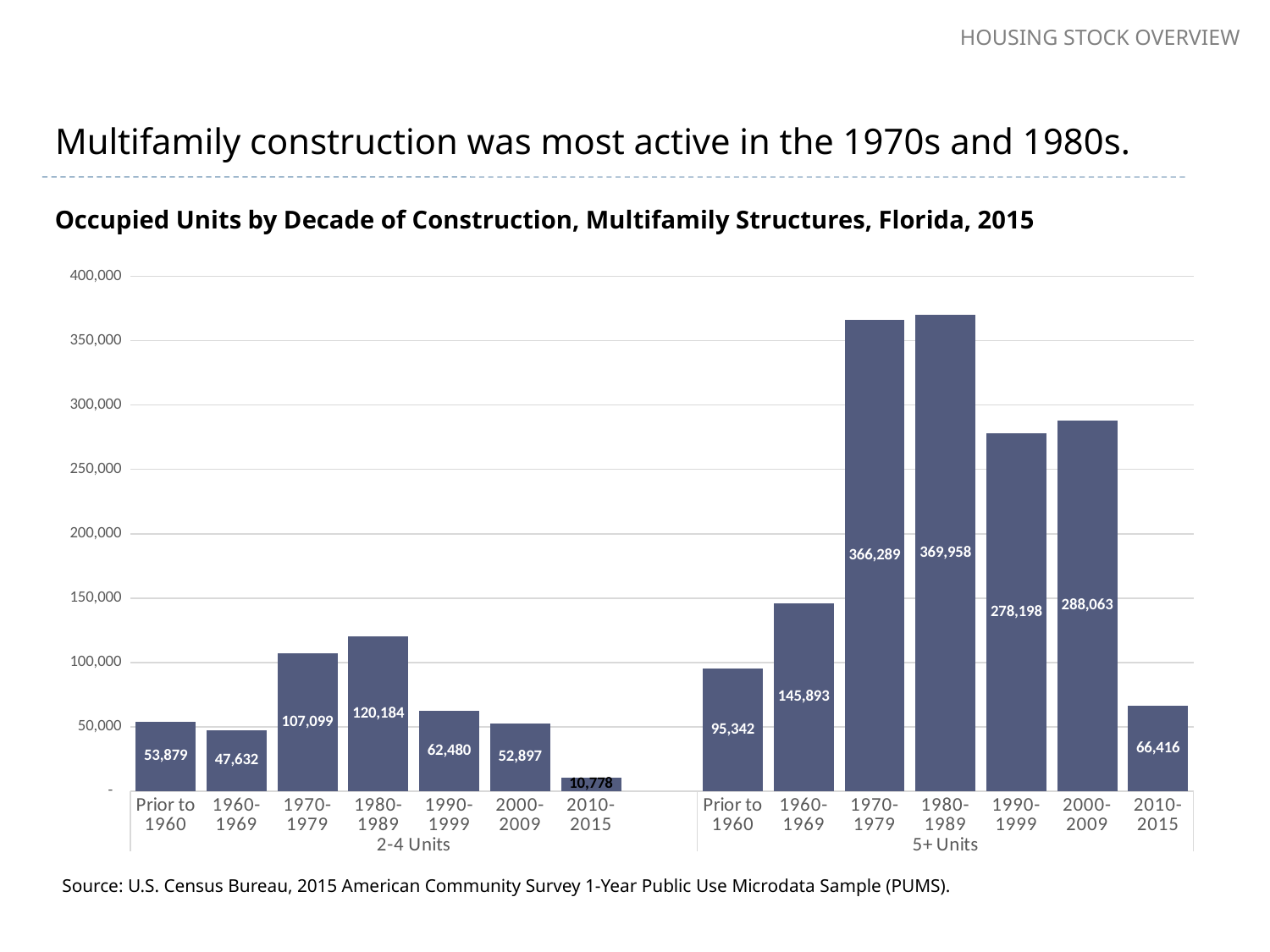
How many bars are plotted on the chart in total? 14 What kind of chart is shown on the slide? Bar chart What is the value for 1980-1989 in the 2-4 Units group? 120,184 Is the value for 1960-1969 in the 5+ Units group greater or less than 100,000? greater Which decade has the highest value in the 5+ Units group? 1980-1989 What is the difference between the 1980-1989 and 1970-1979 values in the 5+ Units group? 3,669 What is the difference between the 2000-2009 and 1990-1999 values in the 5+ Units group? 9,865 Which bar has the lowest value on the whole chart? 2010-2015 in 2-4 Units Which decade has the highest value in the 2-4 Units group? 1980-1989 What is the value for Prior to 1960 in the 5+ Units group? 95,342 What is the value for 1970-1979 in the 5+ Units group? 366,289 In the 2-4 Units group, which is larger: 1990-1999 or 2000-2009? 1990-1999